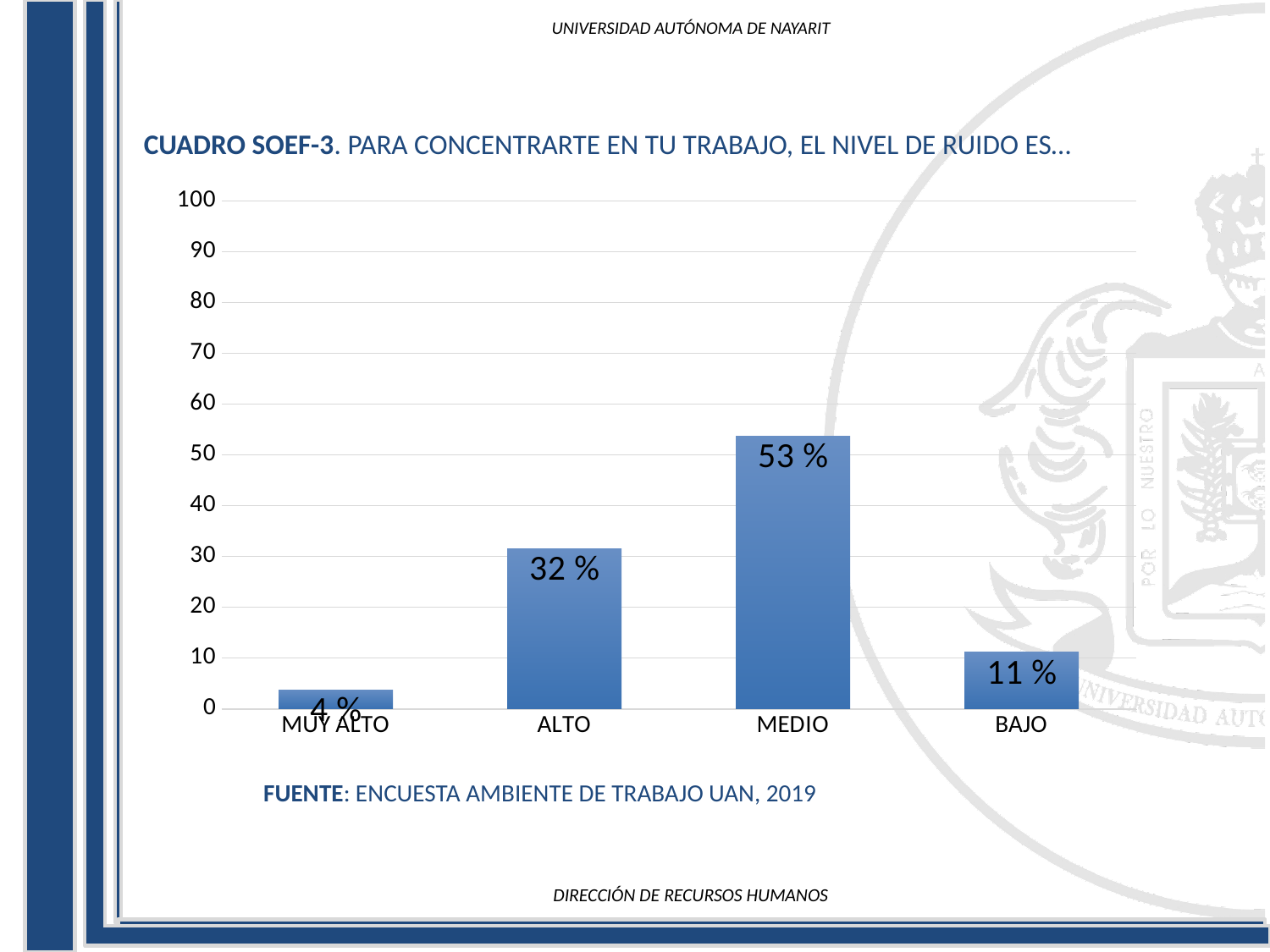
How many categories are shown on the x axis? 4 Which is larger, the value for ALTO or the value for BAJO? ALTO What is the difference between the values for MEDIO and ALTO? 21 % Is the value for MEDIO greater or less than 50? greater What is the value for BAJO? 11 % Which category has the lowest value? MUY ALTO What is the value for MUY ALTO? 4 % What is the value for MEDIO? 53 % What is the value for ALTO? 32 % What is the difference between the values for BAJO and MUY ALTO? 7 % Which category has the highest value? MEDIO What kind of chart is shown on the slide? bar chart